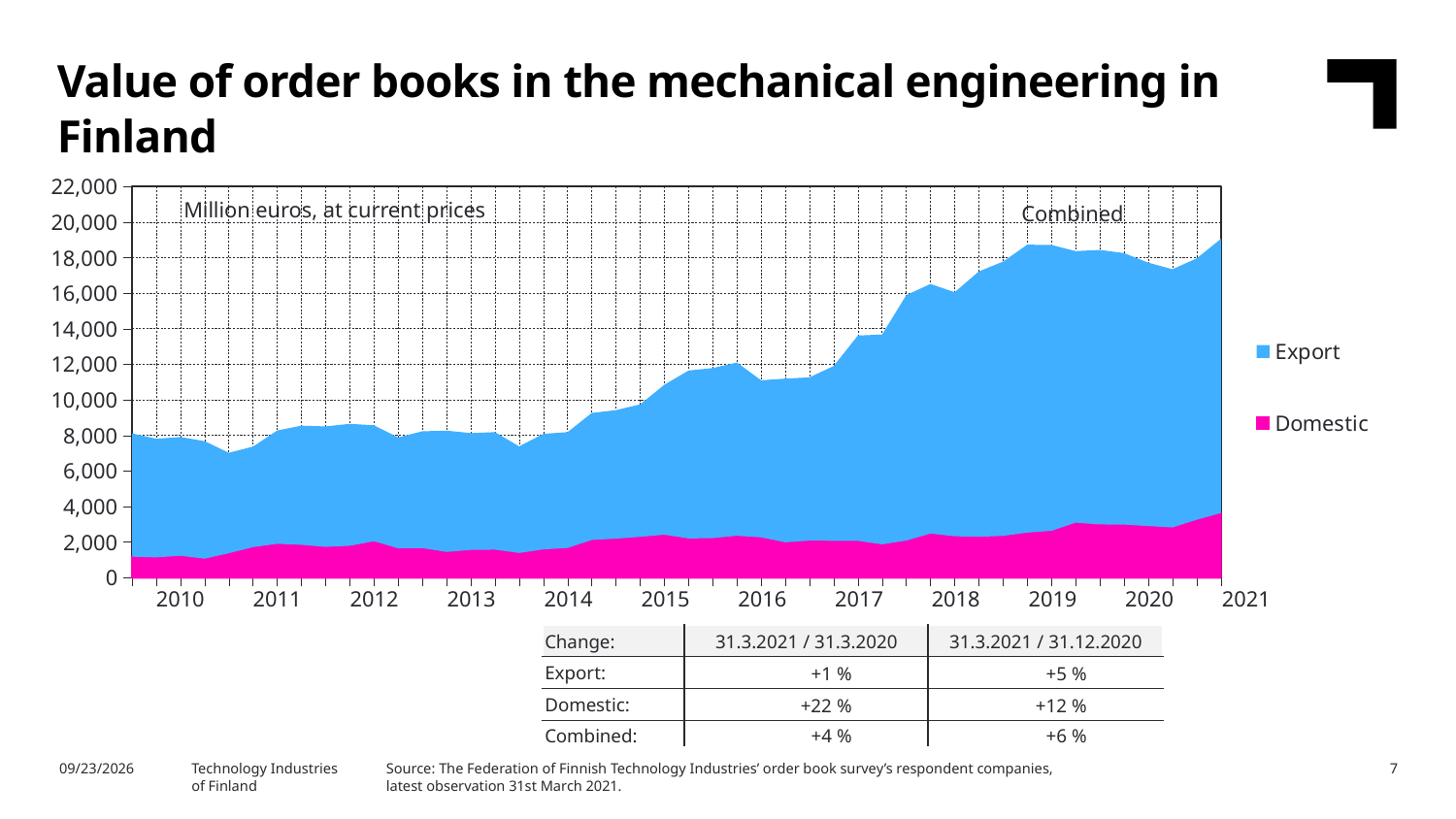
How many series does the chart legend list? 2 Is the combined value at the start of 2014 greater or less than 10,000? less What kind of chart is shown on the slide? Stacked area chart Is the Domestic value at the end of the series in 2021 greater or less than 2,000? greater Is the Domestic value at the start of 2010 greater or less than 2,000? less What unit is stated in the chart's annotation? Million euros, at current prices Which two series are listed in the chart legend? Export and Domestic Which series, Export or Domestic, has the larger values throughout the chart? Export Does the combined value of order books generally rise or fall from 2010 to 2021? rise How many year labels are shown on the x axis? 12